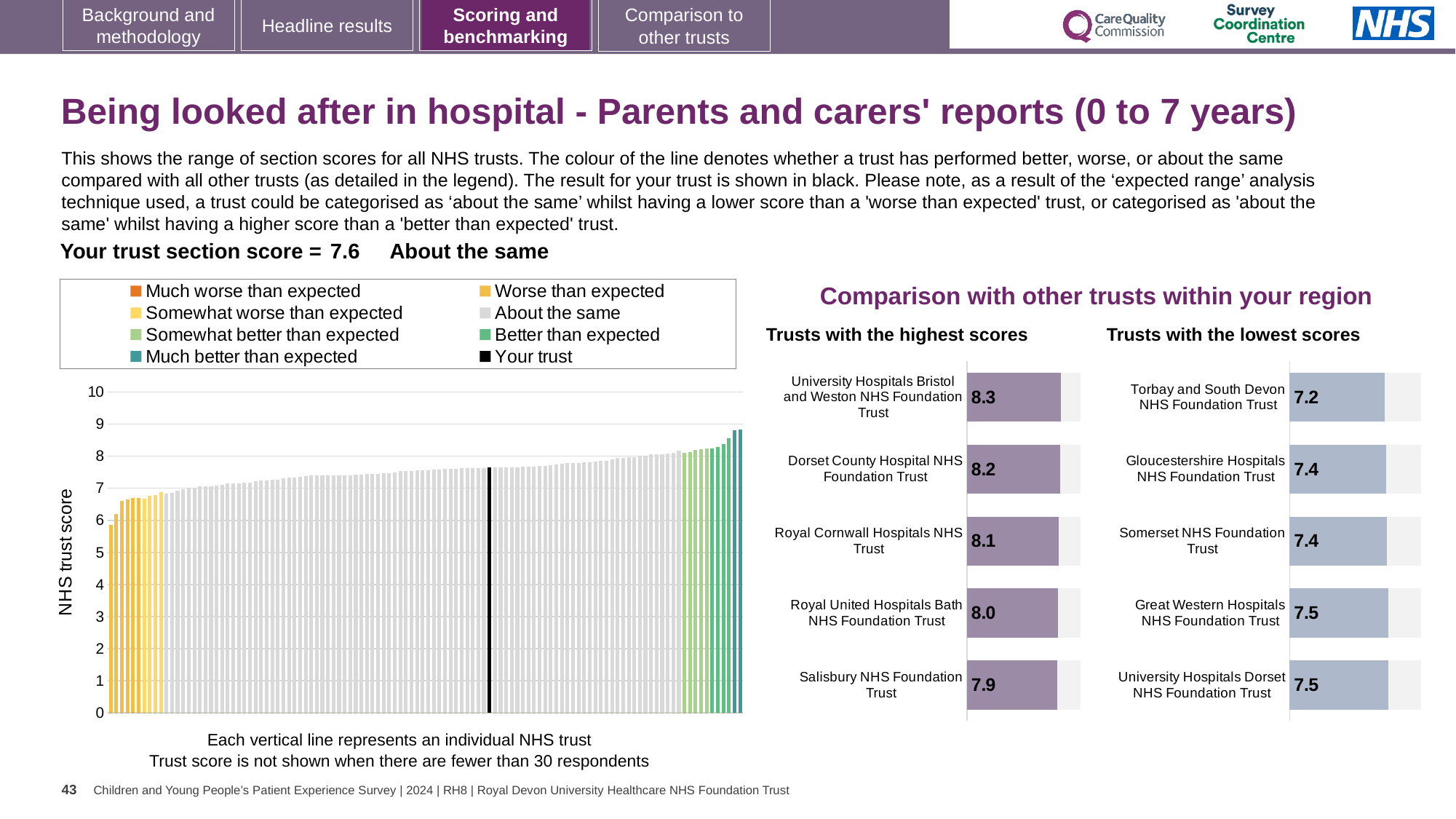
In the 'Trusts with the highest scores' chart, which trust has the highest score? University Hospitals Bristol and Weston NHS Foundation Trust In the 'Trusts with the lowest scores' chart, which trust has the lowest score? Torbay and South Devon NHS Foundation Trust In the 'Trusts with the highest scores' chart, what is the score for University Hospitals Bristol and Weston NHS Foundation Trust? 8.3 In the 'Trusts with the highest scores' chart, which has the larger score: Dorset County Hospital NHS Foundation Trust or Royal Cornwall Hospitals NHS Trust? Dorset County Hospital NHS Foundation Trust How many trusts are listed in the 'Trusts with the lowest scores' chart? 5 In the main chart on the left, what is the section score for your trust (the black bar)? 7.6 In the main chart on the left, do the bar values rise or fall from left to right? rise In the 'Trusts with the highest scores' chart, what is the score for Salisbury NHS Foundation Trust? 7.9 In the 'Trusts with the lowest scores' chart, what is the score for Torbay and South Devon NHS Foundation Trust? 7.2 In the 'Trusts with the highest scores' chart, what is the difference between the scores of University Hospitals Bristol and Weston NHS Foundation Trust and Salisbury NHS Foundation Trust? 0.4 In the main chart on the left, is the value of the tallest bar greater or less than 8? greater How many entries does the legend of the main chart on the left list? 8